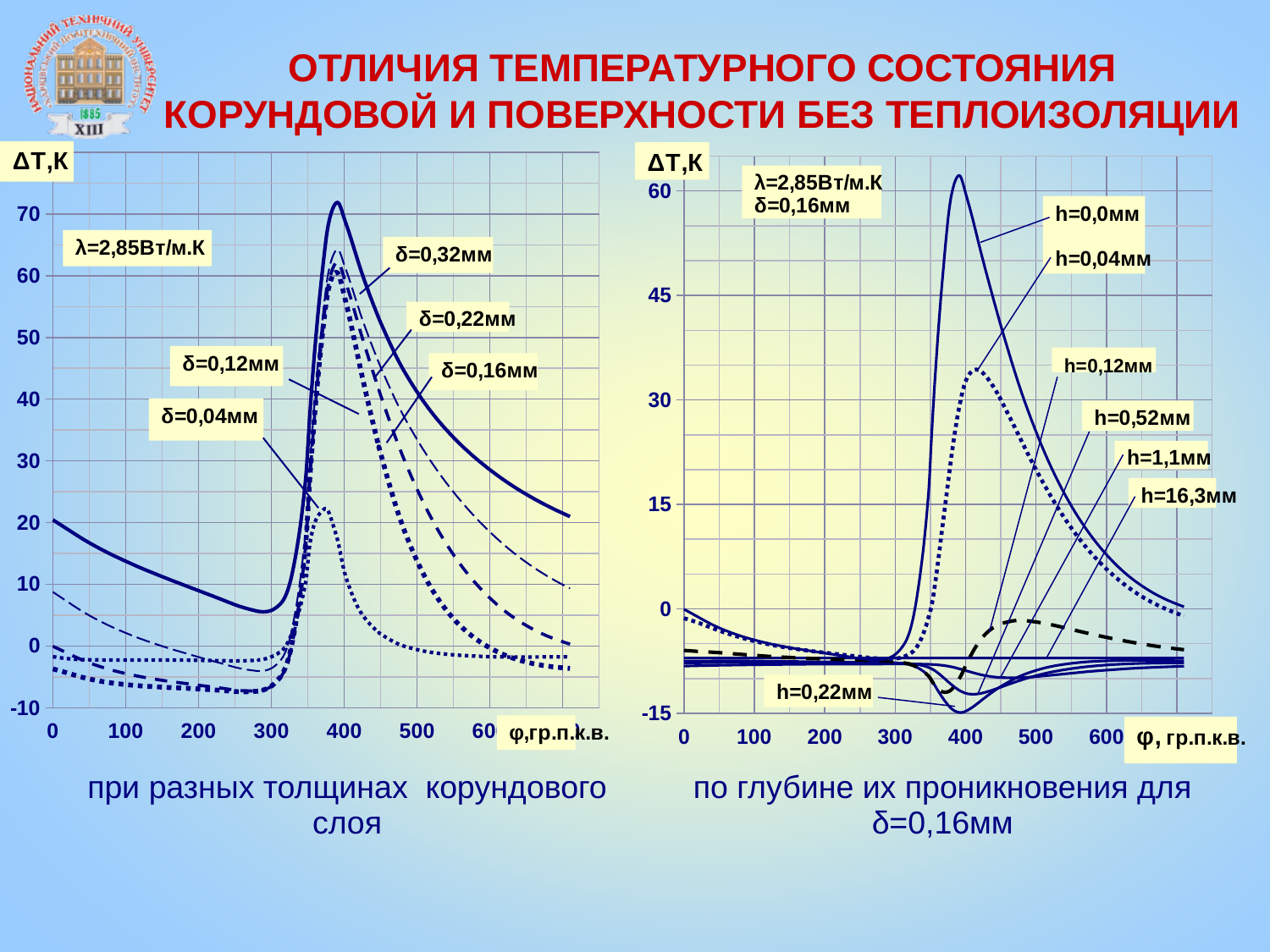
What value of λ is stated on the left chart? λ=2,85Вт/м.К On the left chart, is the peak value of the δ=0,32мм curve greater or less than 60? greater On the left chart, is the peak value of the δ=0,04мм curve greater or less than 30? less On the left chart, how many δ values are labelled on the curves? 5 On the left chart, which δ curve has the lowest peak? δ=0,04мм What kind of chart is the right chart (по глубине их проникновения для δ=0,16мм)? line chart On the right chart, is the peak value of the h=0,0мм curve greater or less than 45? greater What kind of chart is the left chart (при разных толщинах корундового слоя)? line chart On the right chart, does the h=0,0мм curve rise or fall between φ=400 and φ=600? fall On the right chart, how many h values are labelled on the curves? 7 On the left chart, which δ curve reaches the highest peak? δ=0,32мм On the right chart, which h curve reaches the highest peak? h=0,0мм